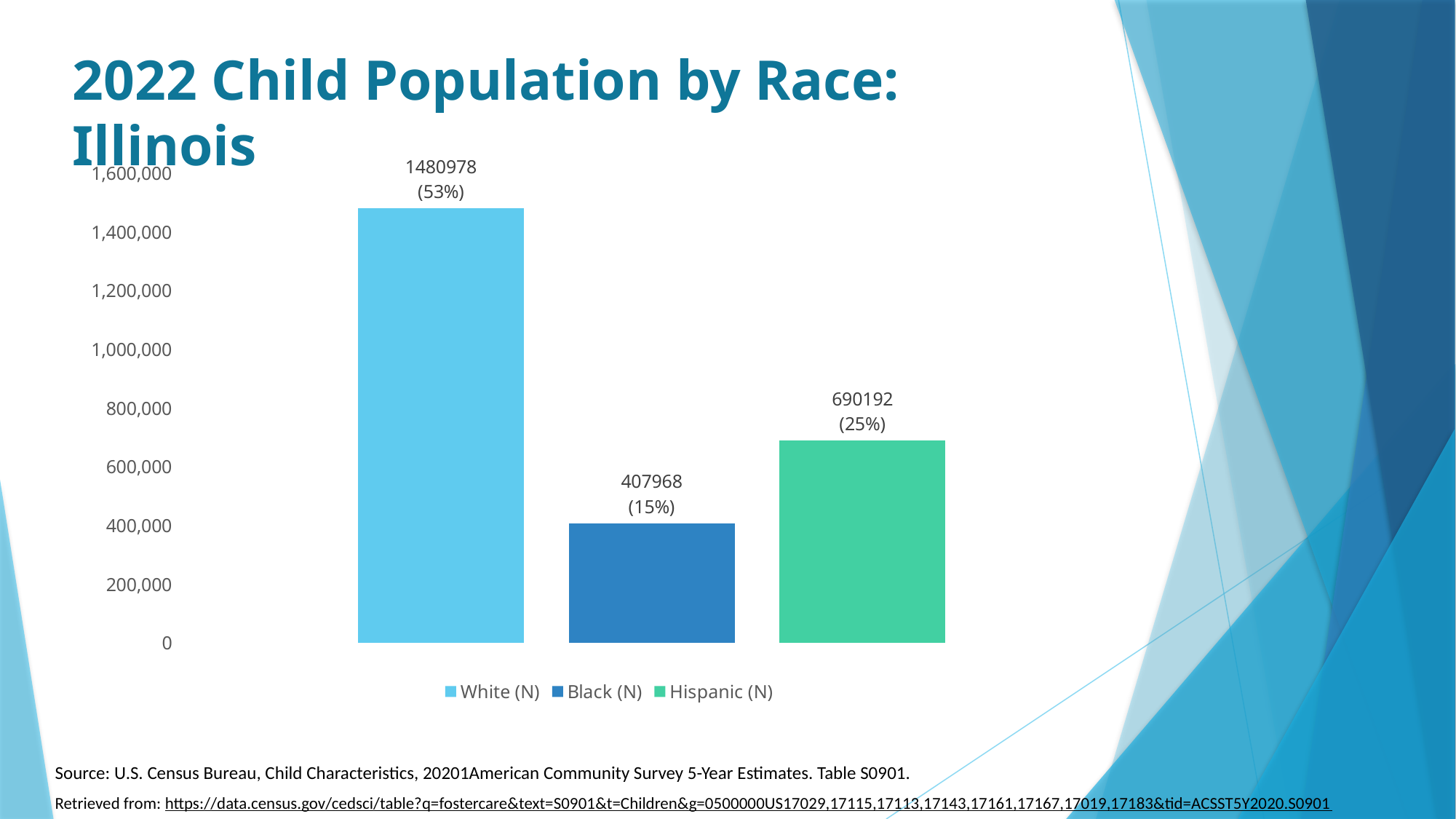
Is the value for White (N) greater or less than 1,400,000? greater How many entries does the legend list? 3 What is the difference between the values for Hispanic (N) and Black (N)? 282224 What is the value shown for White (N)? 1480978 Which group has the highest child population? White (N) Which is larger, the value for Hispanic (N) or the value for Black (N)? Hispanic (N) What kind of chart is shown on the slide? Bar chart What percentage is shown for Hispanic (N)? 25% How many bars are plotted in the chart? 3 What is the difference between the values for White (N) and Hispanic (N)? 790786 Which group has the lowest child population? Black (N) What is the value shown for Black (N)? 407968